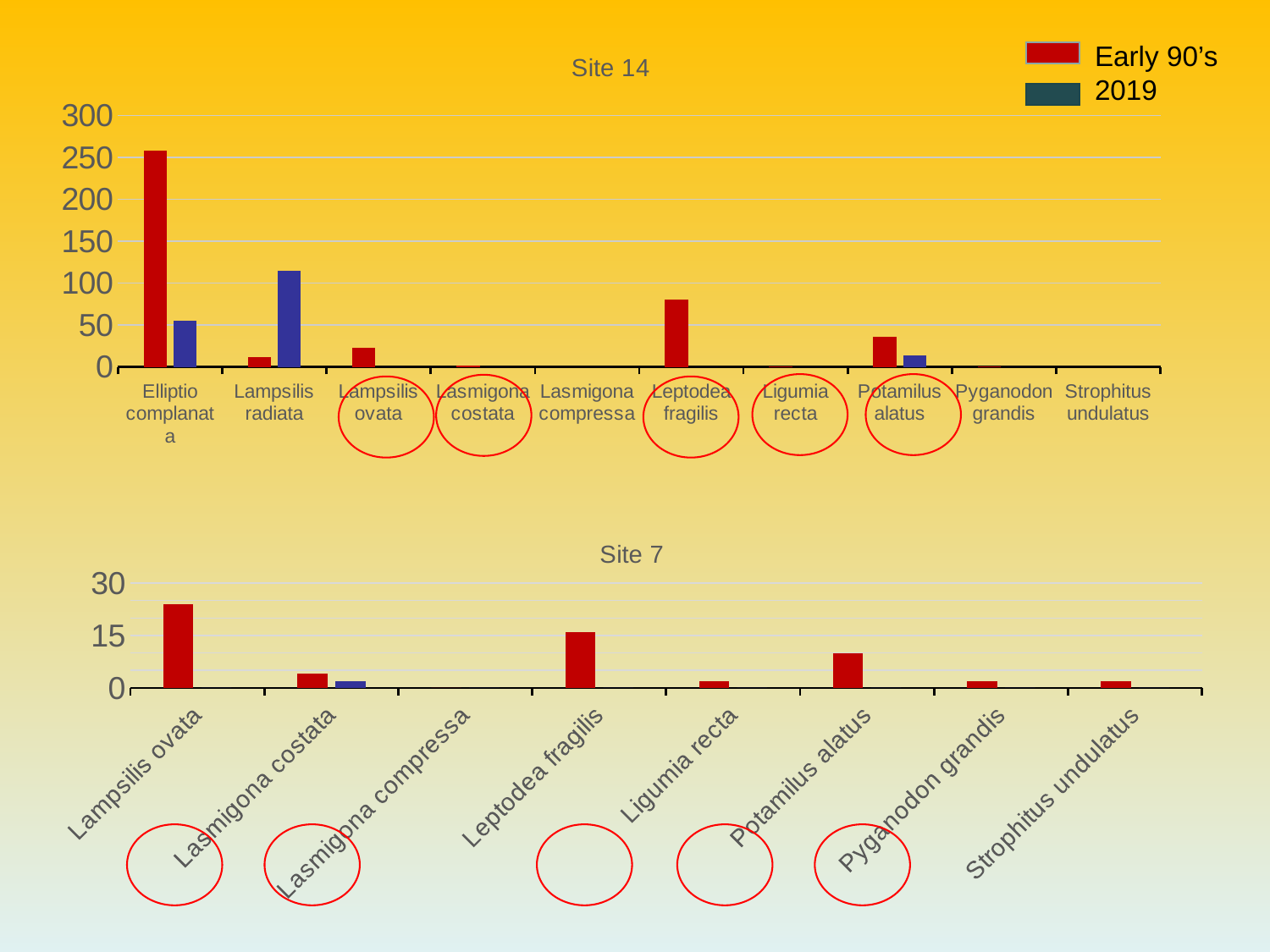
In the Site 7 chart, which species has the highest Early 90's value? Lampsilis ovata In the Site 14 chart, which species has the highest 2019 value? Lampsilis radiata In the Site 14 chart, which species has the highest Early 90's value? Elliptio complanata In the Site 7 chart, is the Early 90's value for Potamilus alatus greater or less than 15? less In the Site 14 chart, is the Early 90's value for Leptodea fragilis greater or less than 100? less Which series is shown in red in the legend? Early 90's In the Site 14 chart, is the Early 90's value for Elliptio complanata greater or less than 200? greater In the Site 14 chart, for Lampsilis radiata, which series has the larger value, Early 90's or 2019? 2019 How many species categories are shown on the x axis of the Site 7 chart? 8 How many species categories are shown on the x axis of the Site 14 chart? 10 How many series does the legend list? 2 What kind of chart is the Site 14 chart? bar chart